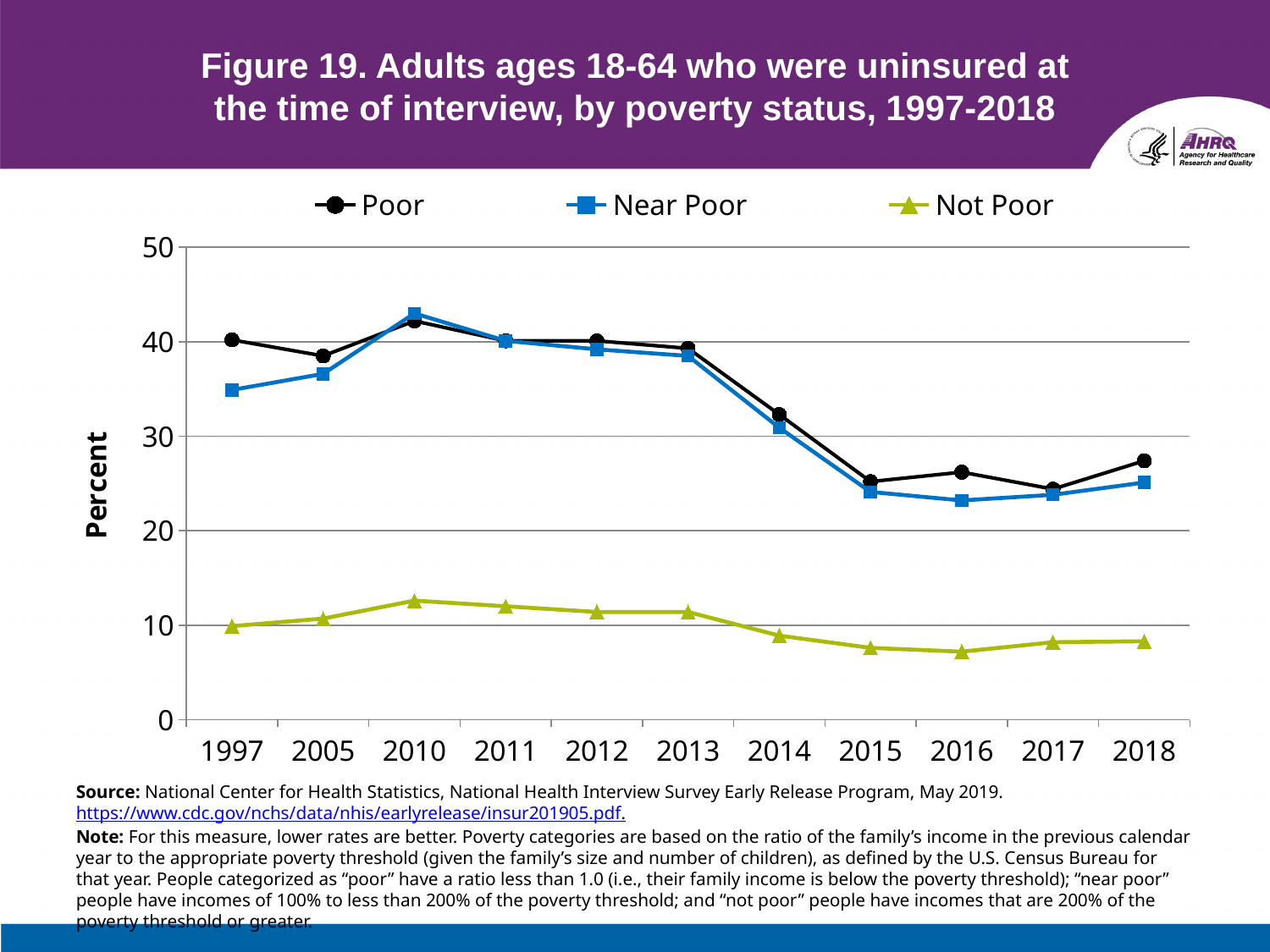
How many series does the legend list? 3 How many years are plotted along the x axis? 11 Is the value for Near Poor in 1997 greater or less than 40? less In 2018, which is larger: the value for Near Poor or the value for Not Poor? Near Poor In which year is the Near Poor series at its highest? 2010 What kind of chart is shown on the slide? Line chart Is the value for Not Poor in 2016 greater or less than 10? less Does the Poor series rise or fall between 2013 and 2015? Fall In 1997, which is larger: the value for Poor or the value for Near Poor? Poor Is the value for Near Poor in 2010 greater or less than 40? greater What is the label on the y axis? Percent